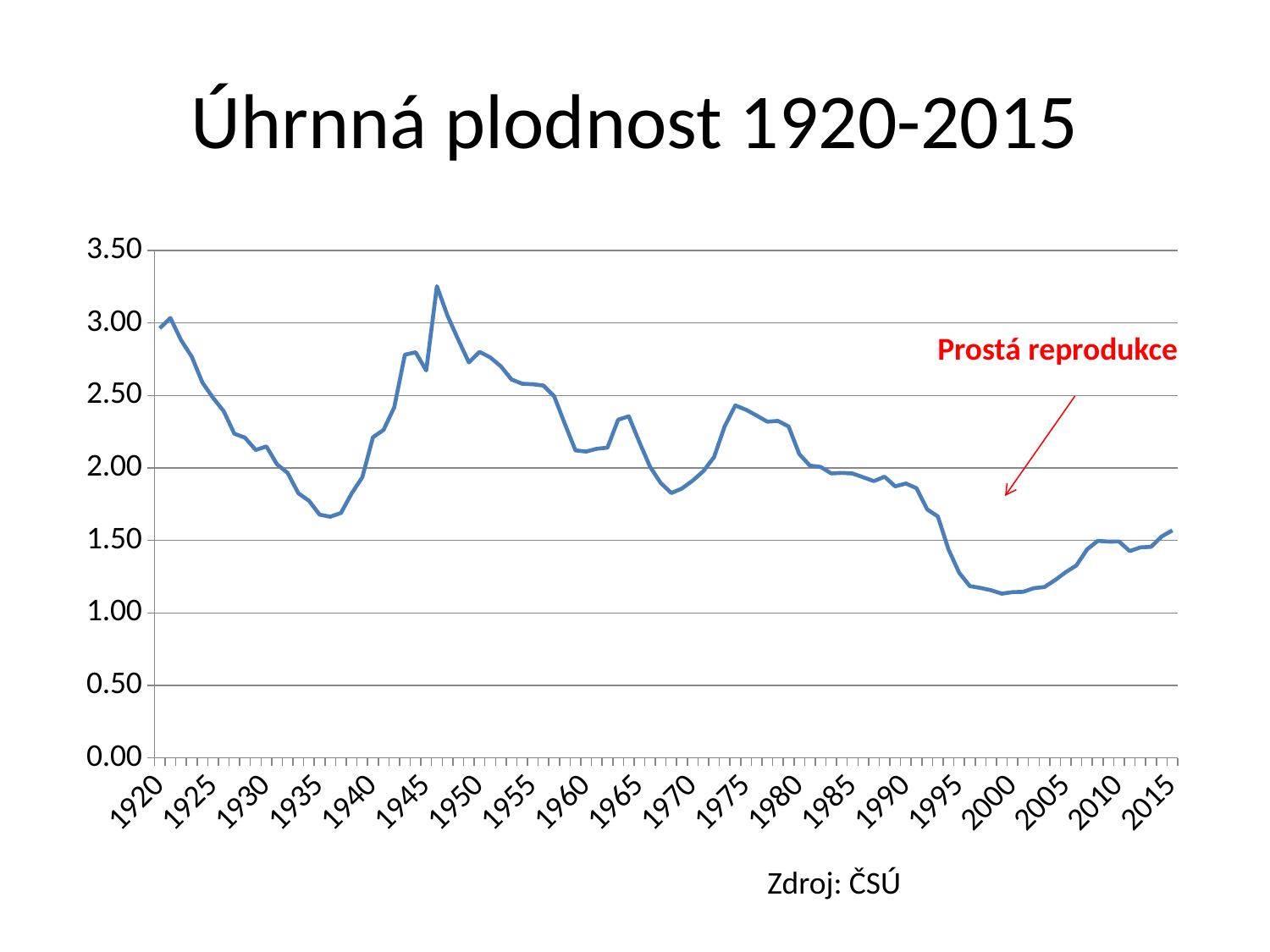
What does the red annotation on the chart say? Prostá reprodukce Is the value for 1950 greater or less than 2.50? greater Does the value rise or fall between 1920 and 1935? fall Which is larger, the value for 1920 or the value for 2015? 1920 Is the value for 1920 greater or less than 2.50? greater Is the value for 2000 greater or less than 1.50? less What kind of chart is shown on the slide? line chart Does the value rise or fall between 2000 and 2015? rise How many year labels are shown on the x axis? 20 Is the highest value on the chart greater or less than 3.00? greater What is the title of the chart? Úhrnná plodnost 1920-2015